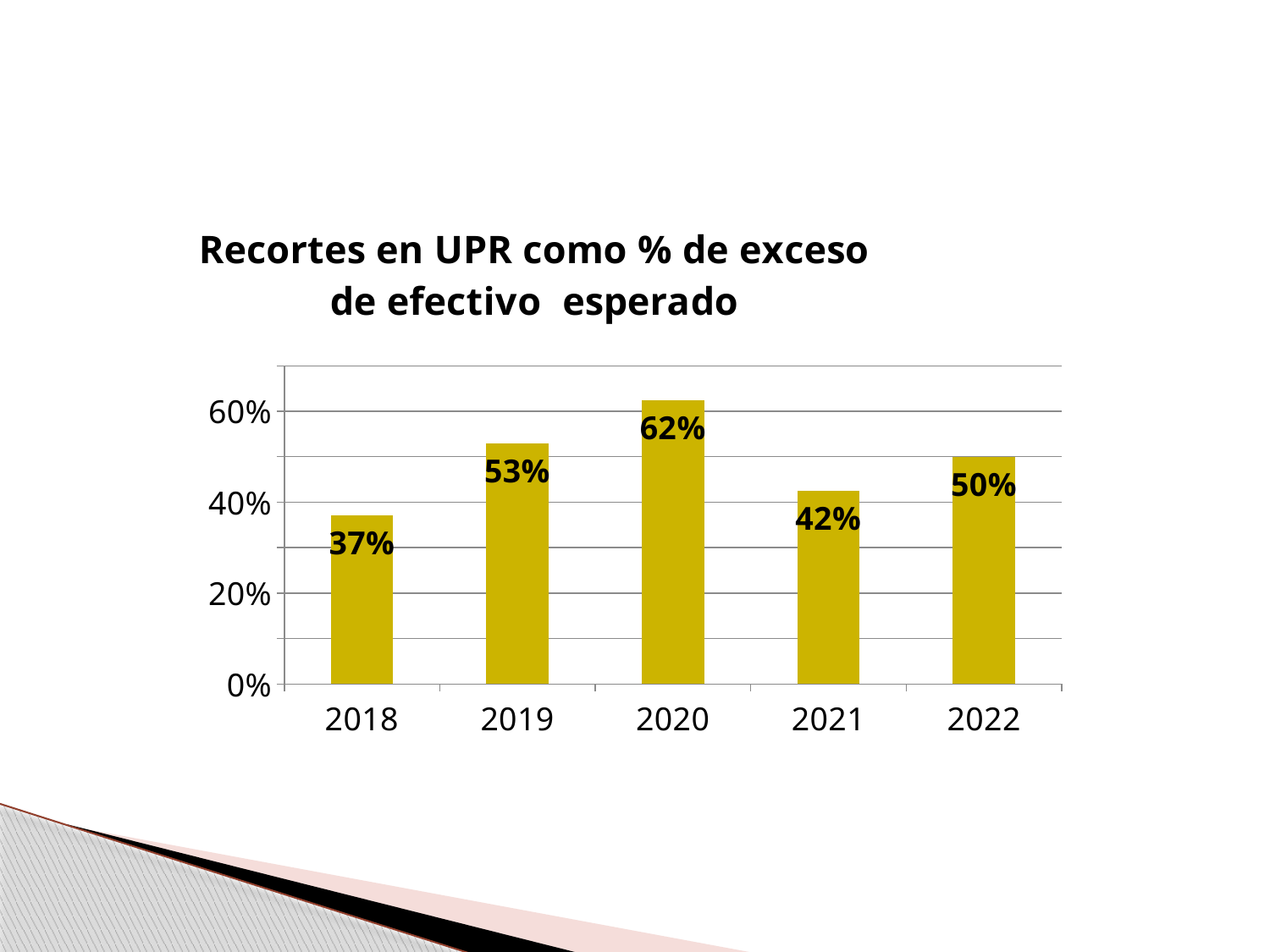
What is the difference between the values for 2020 and 2021? 20% What is the difference between the values for 2019 and 2018? 16% Is the value for 2021 greater or less than 40%? greater What kind of chart is this? bar chart Which year has the highest value? 2020 How many years are shown on the x axis? 5 What is the value for 2018? 37% Which is larger, the value for 2019 or the value for 2022? 2019 What is the value for 2020? 62% Which year has the lowest value? 2018 What is the title of the chart? Recortes en UPR como % de exceso de efectivo esperado What is the value for 2022? 50%